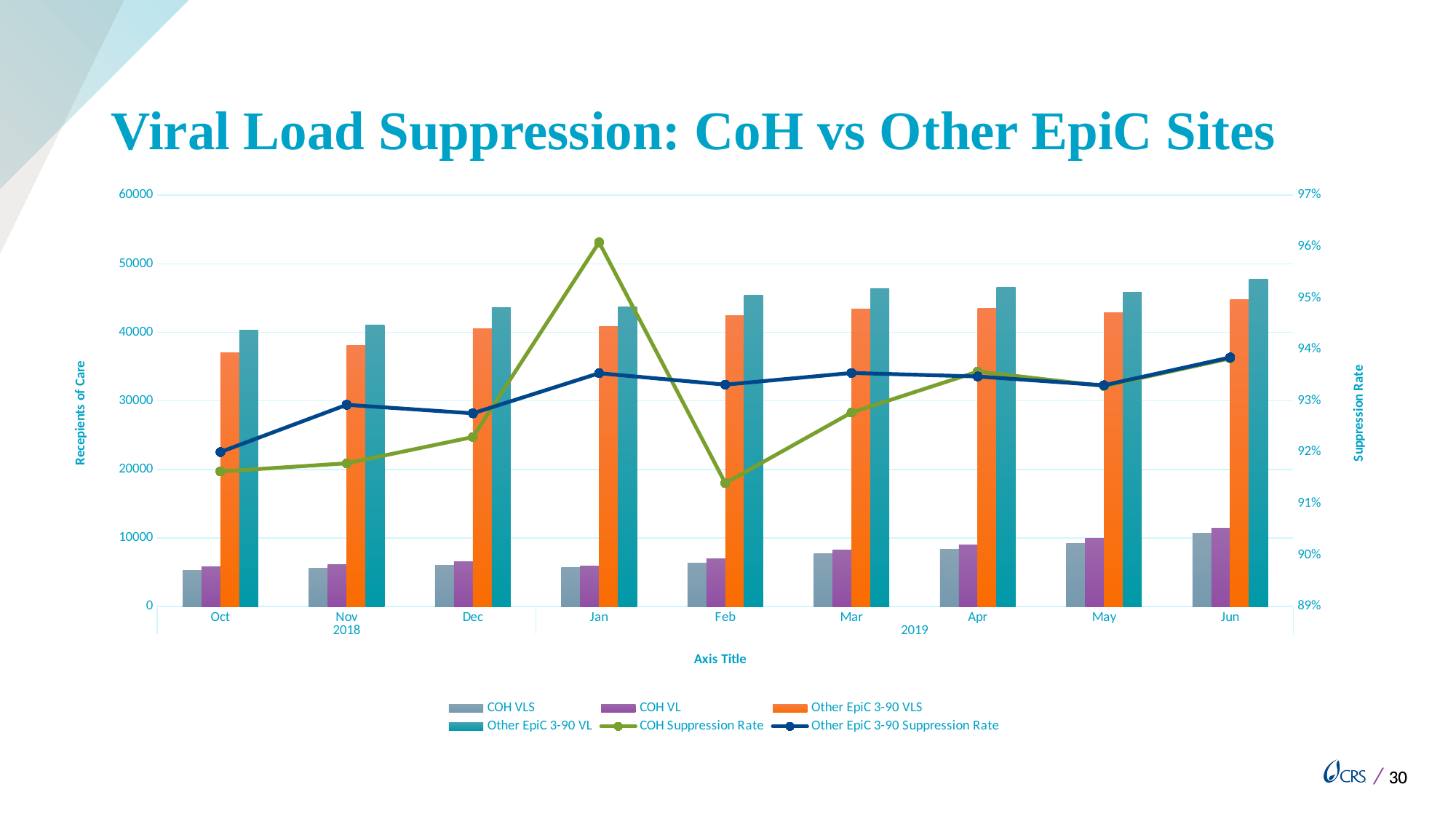
Is the value for Other EpiC 3-90 VLS in Oct greater or less than 40000? less In which month is the Other EpiC 3-90 VL bar highest? Jun Is the value for COH VL in Jun greater or less than 10000? greater In Jan, which is higher: the COH Suppression Rate or the Other EpiC 3-90 Suppression Rate? COH Suppression Rate How many series does the legend list? 6 In which month is the COH Suppression Rate highest? Jan In Feb, which is higher: the COH Suppression Rate or the Other EpiC 3-90 Suppression Rate? Other EpiC 3-90 Suppression Rate How many months are shown along the x axis? 9 In which month is the COH Suppression Rate lowest? Feb What kind of chart is shown on the slide? A combination bar and line chart Is the COH Suppression Rate in Jan greater or less than 95%? greater What is the title of the right-hand vertical axis? Suppression Rate